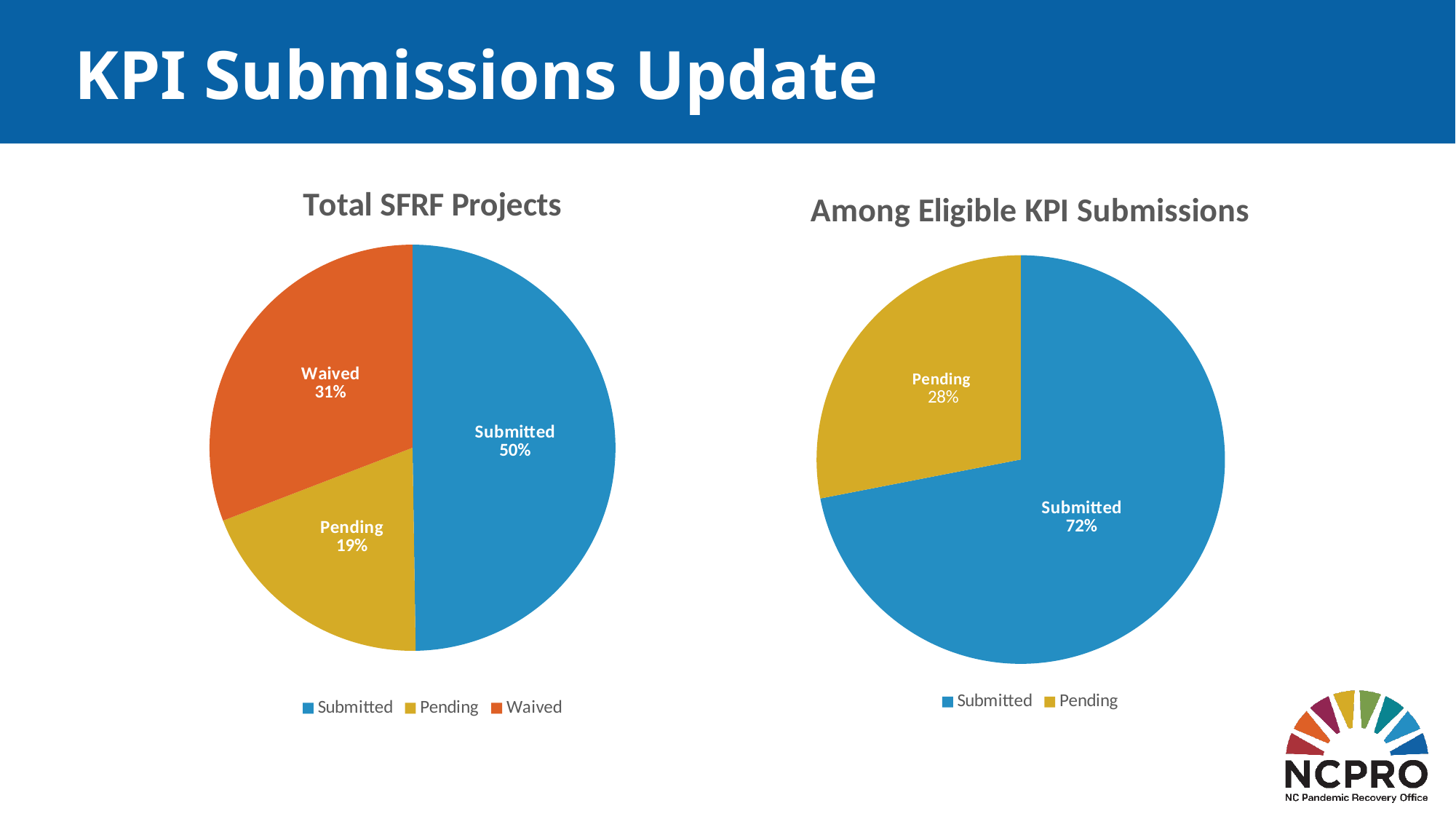
In the 'Total SFRF Projects' chart, which category has the largest share? Submitted How many entries does the legend of the 'Among Eligible KPI Submissions' chart list? 2 In the 'Among Eligible KPI Submissions' chart, what share is Submitted? 72% How many slices does the 'Total SFRF Projects' chart have? 3 In the 'Among Eligible KPI Submissions' chart, what share is Pending? 28% In the 'Total SFRF Projects' chart, what share of projects is Waived? 31% In the 'Among Eligible KPI Submissions' chart, what is the difference in percentage points between Submitted and Pending? 44 In the 'Total SFRF Projects' chart, what share of projects is Pending? 19% In the 'Total SFRF Projects' chart, which is larger, Waived or Pending? Waived In the 'Total SFRF Projects' chart, what is the difference in percentage points between Submitted and Waived? 19 What type of chart is the 'Among Eligible KPI Submissions' chart? Pie chart In the 'Total SFRF Projects' chart, which category has the smallest share? Pending